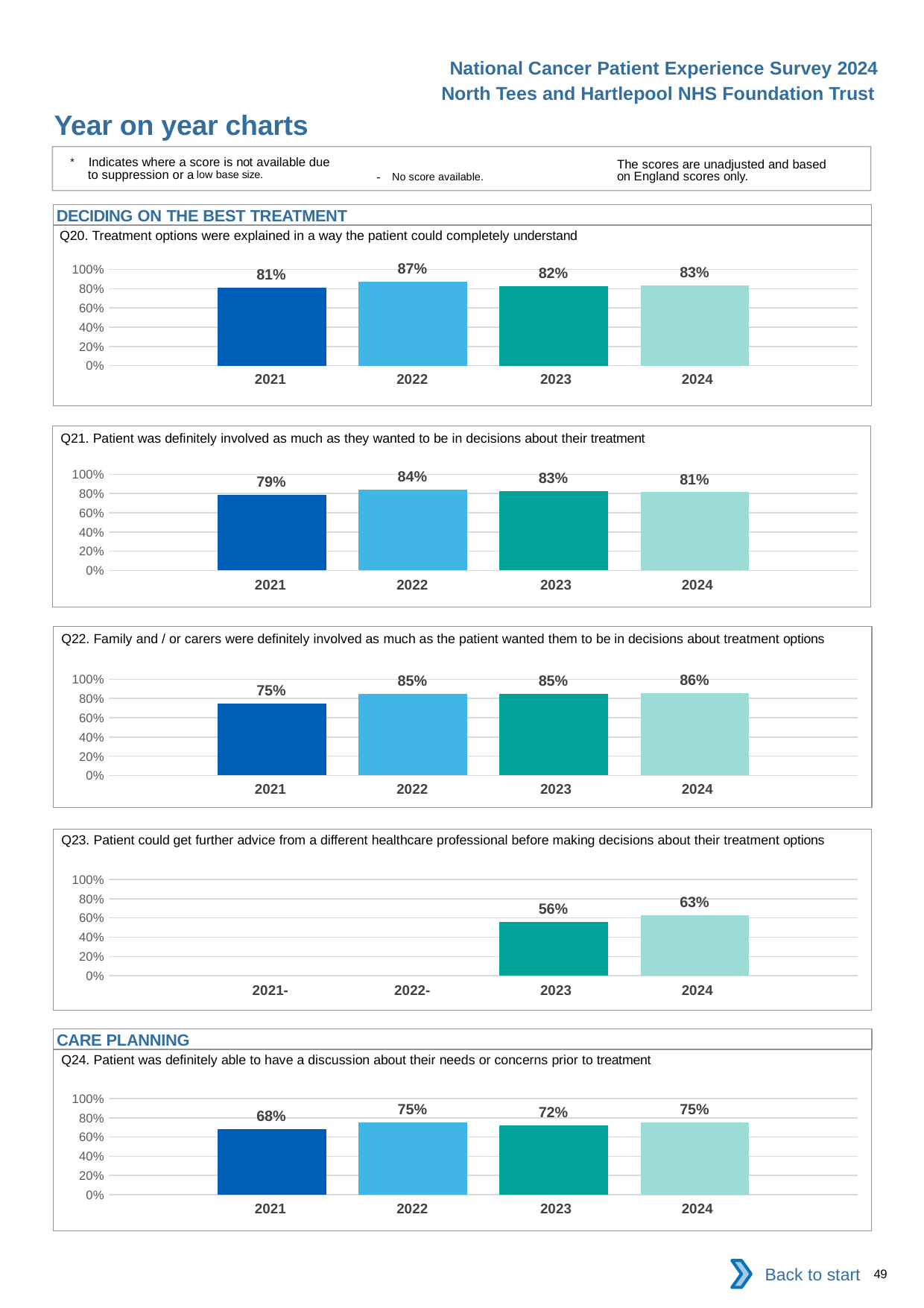
In the Q22 chart, how many years are shown on the x axis? 4 In the Q20 chart, what is the value for 2022? 87% In the Q21 chart, which year has the highest value? 2022 In the Q23 chart, how many years have a bar plotted? 2 In the Q20 chart, which year has the lowest value? 2021 In the Q23 chart, what is the value for 2024? 63% In the Q22 chart, is the value for 2024 larger or smaller than the value for 2021? larger In the Q24 chart, what is the difference between the 2024 and 2021 values? 7 percentage points What kind of chart is the Q20 chart? bar chart In the Q22 chart, what is the value for 2021? 75% In the Q24 chart, what is the value for 2023? 72% In the Q21 chart, what is the difference between the 2022 and 2021 values? 5 percentage points